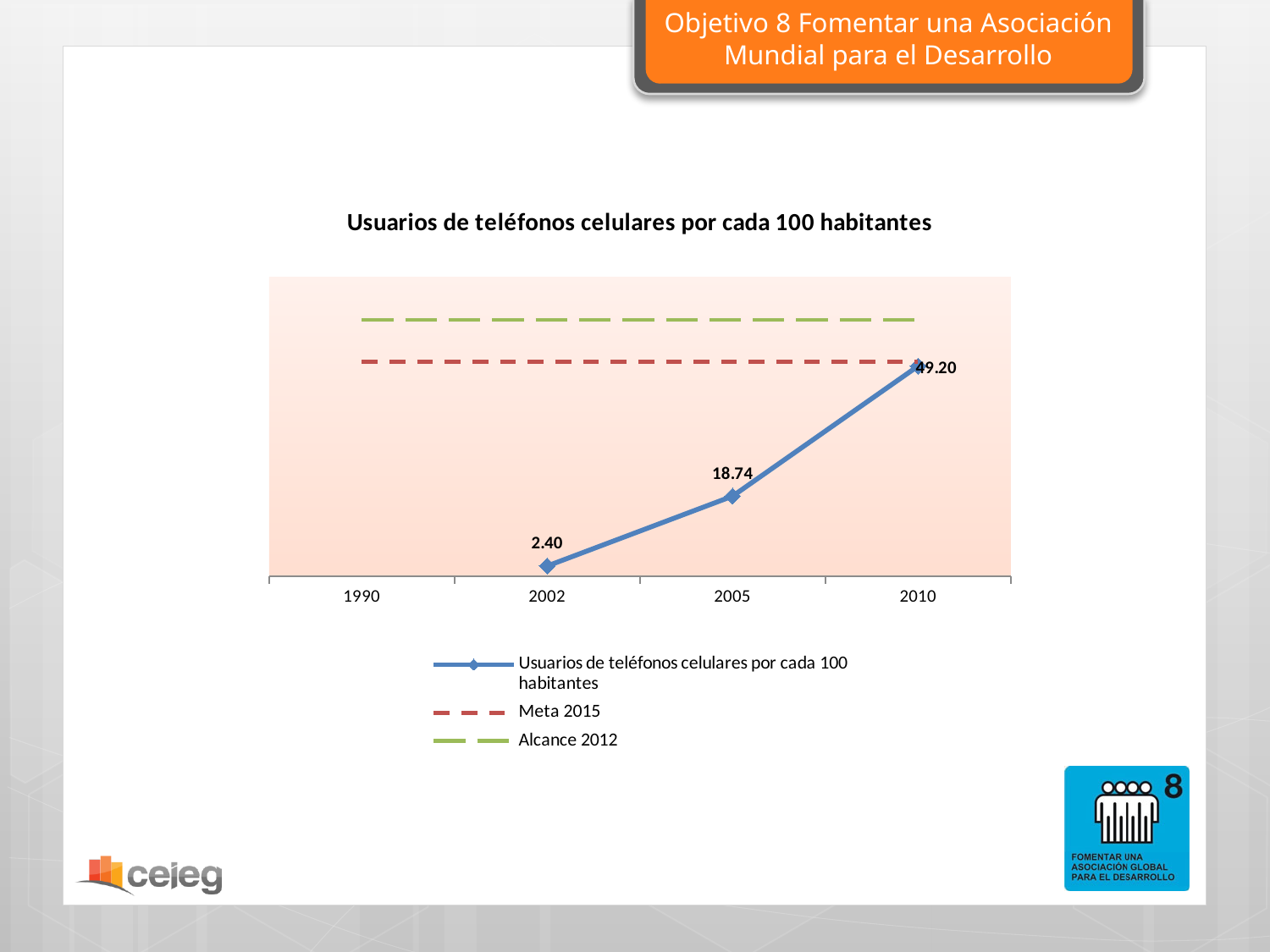
What is the difference between the 2005 and 2002 values of cellular phone users per 100 inhabitants? 16.34 What kind of chart is shown on the slide? Line chart How many series does the legend list? 3 What is the title of the chart? Usuarios de teléfonos celulares por cada 100 habitantes Do the values of cellular phone users per 100 inhabitants rise or fall from 2002 to 2010? Rise In which year is the plotted value of cellular phone users per 100 inhabitants highest? 2010 What is the difference between the 2010 and 2005 values of cellular phone users per 100 inhabitants? 30.46 Which year has a larger value of cellular phone users per 100 inhabitants, 2002 or 2005? 2005 What is the value of Usuarios de teléfonos celulares por cada 100 habitantes in 2002? 2.40 What is the value of Usuarios de teléfonos celulares por cada 100 habitantes in 2010? 49.20 In which year is the plotted value of cellular phone users per 100 inhabitants lowest? 2002 What is the value of Usuarios de teléfonos celulares por cada 100 habitantes in 2005? 18.74